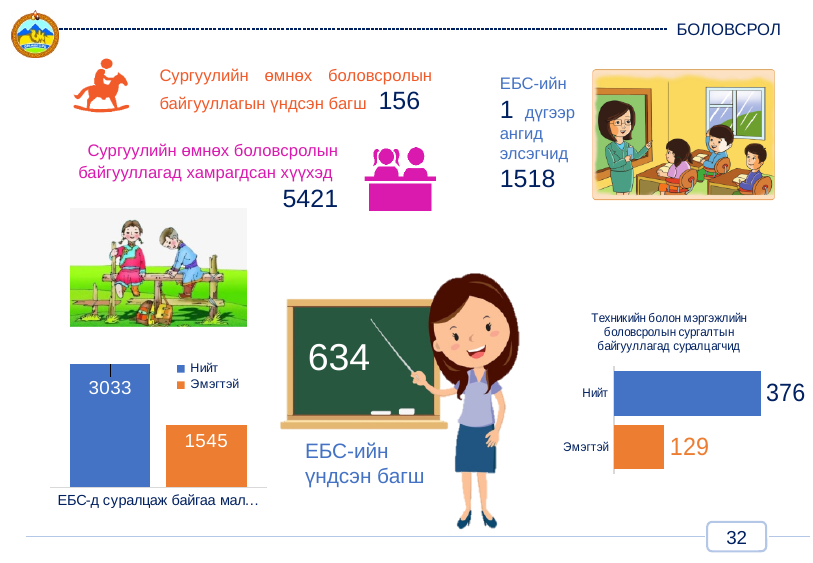
In the bottom-left bar chart, what is the value for Нийт? 3033 In the bottom-left bar chart, which is larger, Нийт or Эмэгтэй? Нийт In the bottom-left bar chart, what is the difference between the Нийт and Эмэгтэй values? 1488 In the bottom-right chart, which category has the lowest value? Эмэгтэй How many bars are shown in the bottom-right chart? 2 In the bottom-right chart titled 'Техникийн болон мэргэжлийн боловсролын сургалтын байгууллагад суралцагчид', what is the value for Нийт? 376 In the bottom-right chart, what is the difference between the Нийт and Эмэгтэй values? 247 In the bottom-left bar chart, what is the value for Эмэгтэй? 1545 In the bottom-left chart, what colour is the Эмэгтэй bar? orange How many series does the legend of the bottom-left chart list? 2 What kind of chart is the bottom-left chart? bar chart In the bottom-right chart titled 'Техникийн болон мэргэжлийн боловсролын сургалтын байгууллагад суралцагчид', what is the value for Эмэгтэй? 129